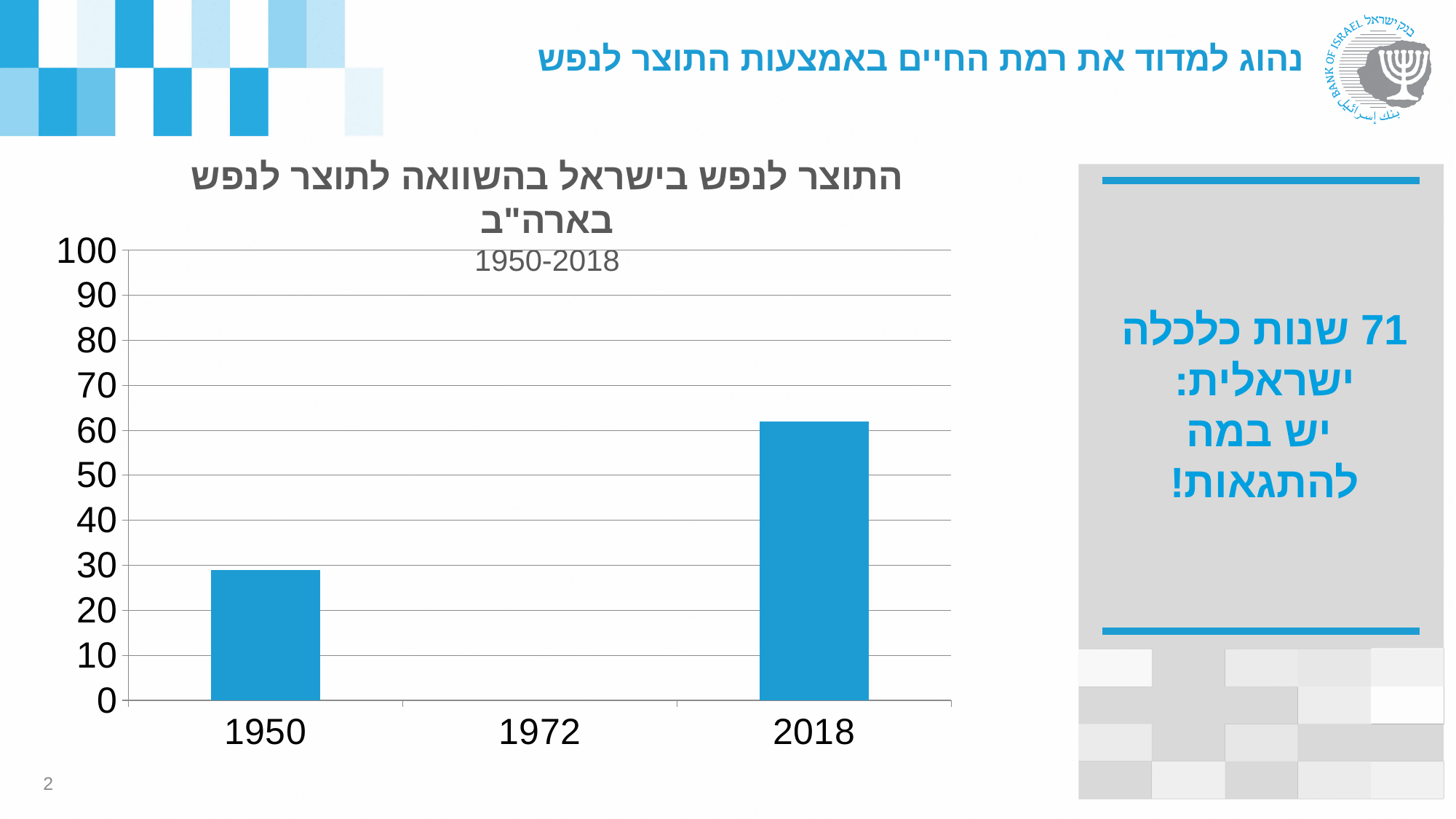
What kind of chart is shown on the slide? bar chart Which of the plotted bars is the shortest? 1950 Is the value for 1950 greater or less than 20? greater Which year has the tallest bar in the chart? 2018 Do the bar values rise or fall from 1950 to 2018? rise What period is given in the subtitle under the chart title? 1950-2018 Which is larger, the value for 1950 or the value for 2018? 2018 Is the value for 2018 greater or less than 50? greater Is the value for 1950 greater or less than 40? less How many year categories are labelled on the x axis of the chart? 3 What is the highest value shown on the chart's y axis? 100